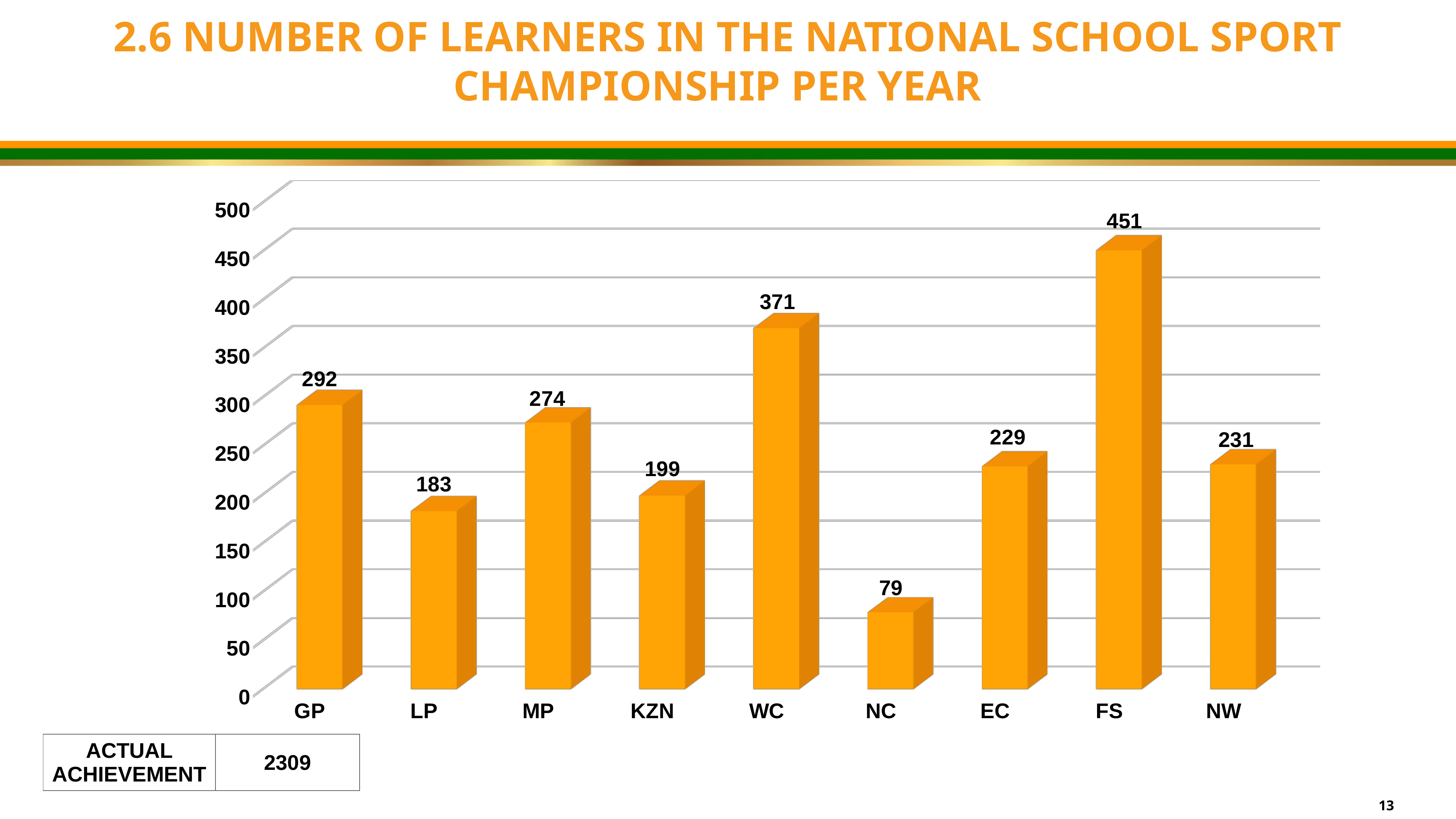
How many provinces are shown on the x axis? 9 Is the value for KZN greater or less than 250? less Which is larger, the value for EC or the value for NW? NW What is the value for GP? 292 What is the value for NC? 79 What is the difference between the values for FS and WC? 80 Which province has the highest number of learners? FS What kind of chart is shown on the slide? bar chart Which province has the lowest number of learners? NC What is the actual achievement figure shown in the table below the chart? 2309 What is the difference between the values for MP and LP? 91 What is the value for WC? 371